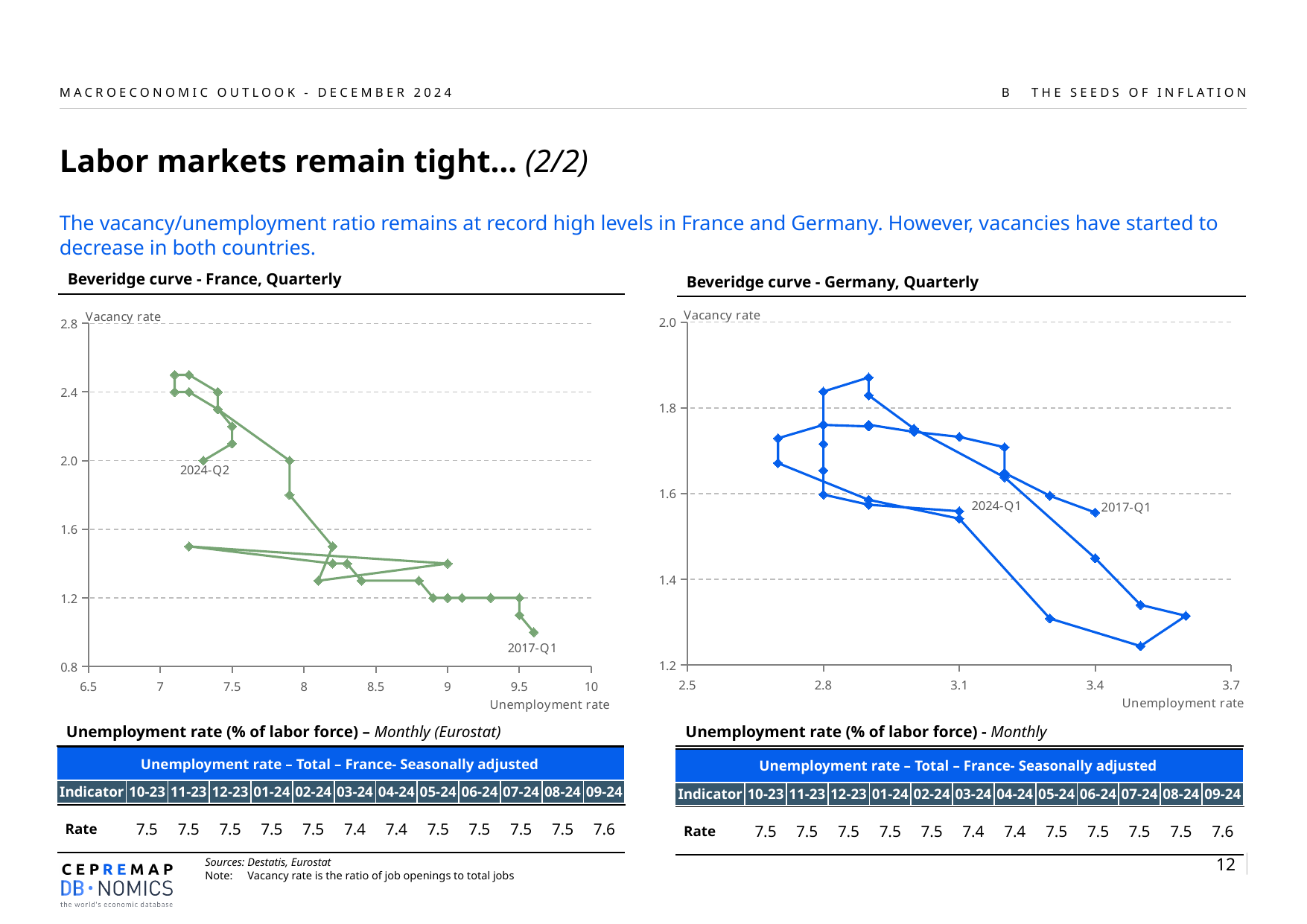
In the 'Beveridge curve - France, Quarterly' chart, is the vacancy rate for 2017-Q1 greater or less than 1.2? less In the 'Beveridge curve - France, Quarterly' chart, which point has the higher vacancy rate, 2017-Q1 or 2024-Q2? 2024-Q2 What is the label of the vertical axis in the 'Beveridge curve - France, Quarterly' chart? Vacancy rate What kind of chart is the 'Beveridge curve - France, Quarterly' chart? line chart In the 'Beveridge curve - Germany, Quarterly' chart, does the vacancy rate generally rise or fall as the unemployment rate increases along the x axis? fall In the 'Beveridge curve - France, Quarterly' chart, is the unemployment rate for 2017-Q1 greater or less than 9.5? greater In the 'Beveridge curve - Germany, Quarterly' chart, is the vacancy rate for 2017-Q1 greater or less than 1.6? less What is the highest value shown on the vertical axis of the 'Beveridge curve - Germany, Quarterly' chart? 2.0 In the 'Beveridge curve - Germany, Quarterly' chart, which point has the higher unemployment rate, 2017-Q1 or 2024-Q1? 2017-Q1